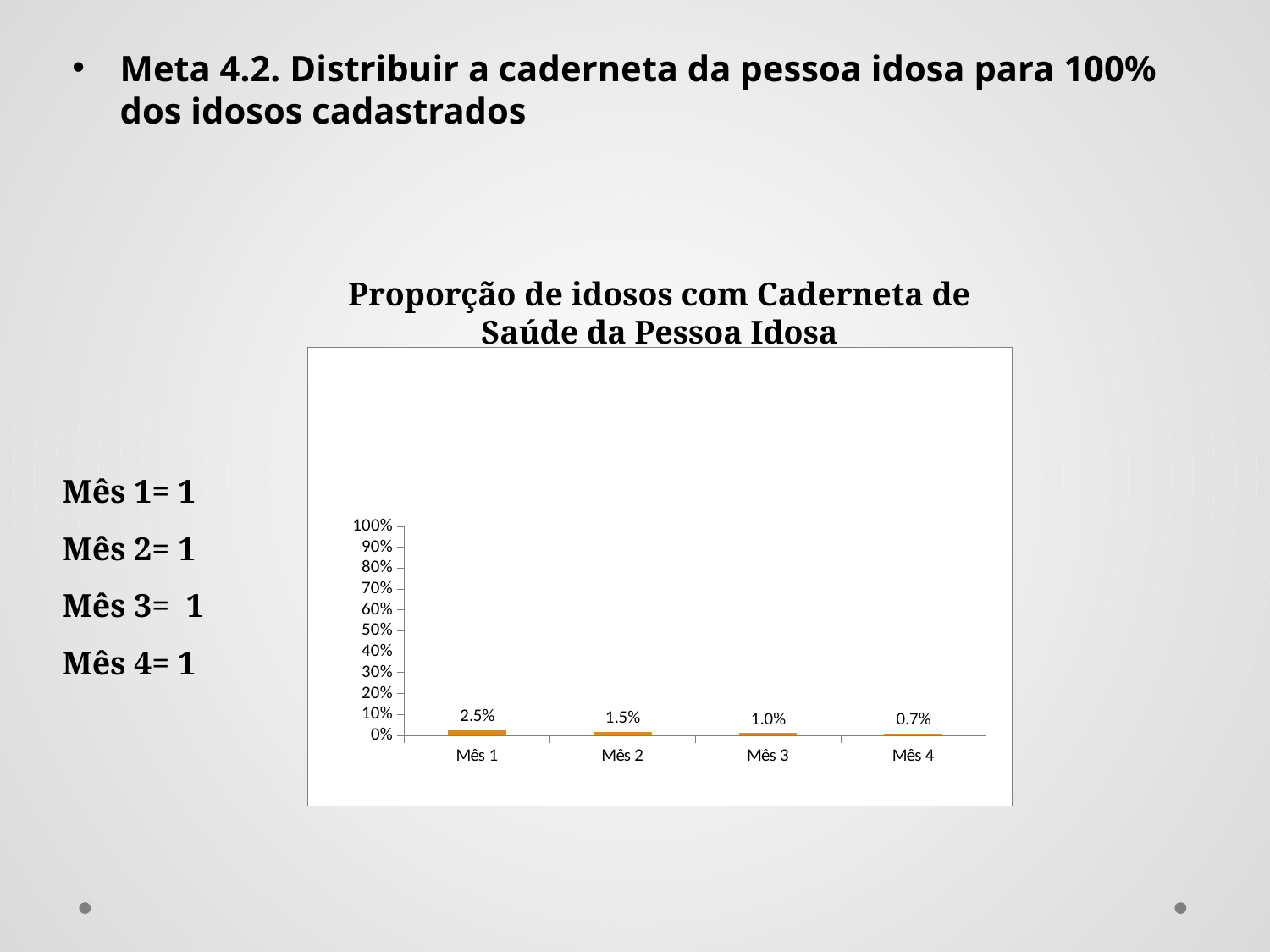
How many months are shown on the x axis? 4 What is the difference between the values for Mês 1 and Mês 4? 1.8% What is the value for Mês 2? 1.5% Is the value for Mês 1 greater or less than 10%? less What kind of chart is shown? bar chart What is the value for Mês 3? 1.0% Do the values rise or fall from Mês 1 to Mês 4? fall What is the value for Mês 1? 2.5% Which is larger, the value for Mês 2 or the value for Mês 3? Mês 2 What is the value for Mês 4? 0.7% Which month has the highest value? Mês 1 Which month has the lowest value? Mês 4